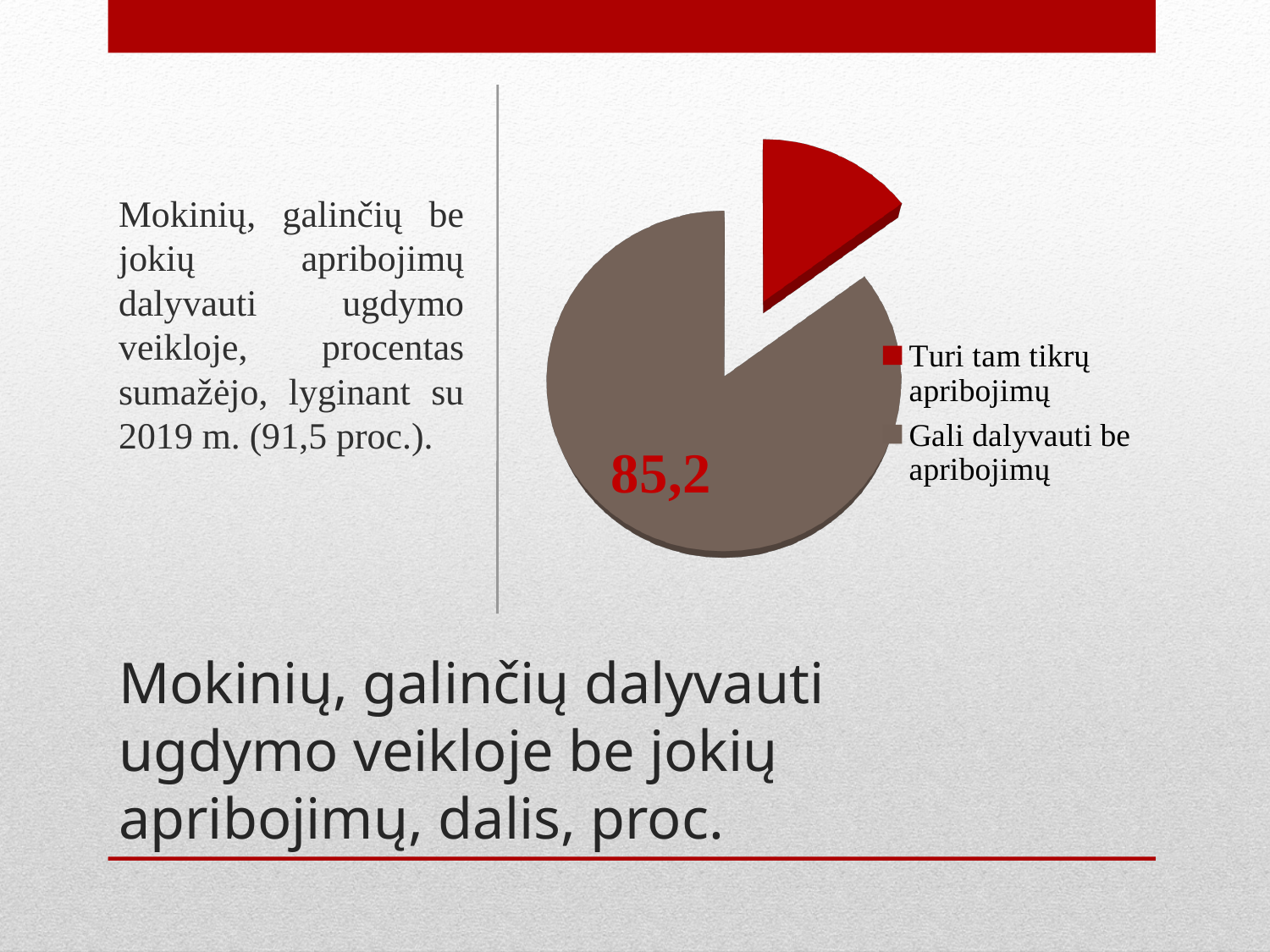
What value is printed on the 'Gali dalyvauti be apribojimų' slice of the pie chart? 85,2 Which slice of the pie chart is the largest? Gali dalyvauti be apribojimų Which legend entry is listed first in the pie chart's legend? Turi tam tikrų apribojimų What kind of chart is shown on the slide? pie chart How many slices does the pie chart have? 2 Which slice of the pie chart is the smallest? Turi tam tikrų apribojimų What colour is the 'Turi tam tikrų apribojimų' slice in the pie chart? red How many entries does the legend of the pie chart list? 2 Which is larger in the pie chart: 'Turi tam tikrų apribojimų' or 'Gali dalyvauti be apribojimų'? Gali dalyvauti be apribojimų What share of the pie does the 'Gali dalyvauti be apribojimų' slice represent, as printed on the chart? 85,2